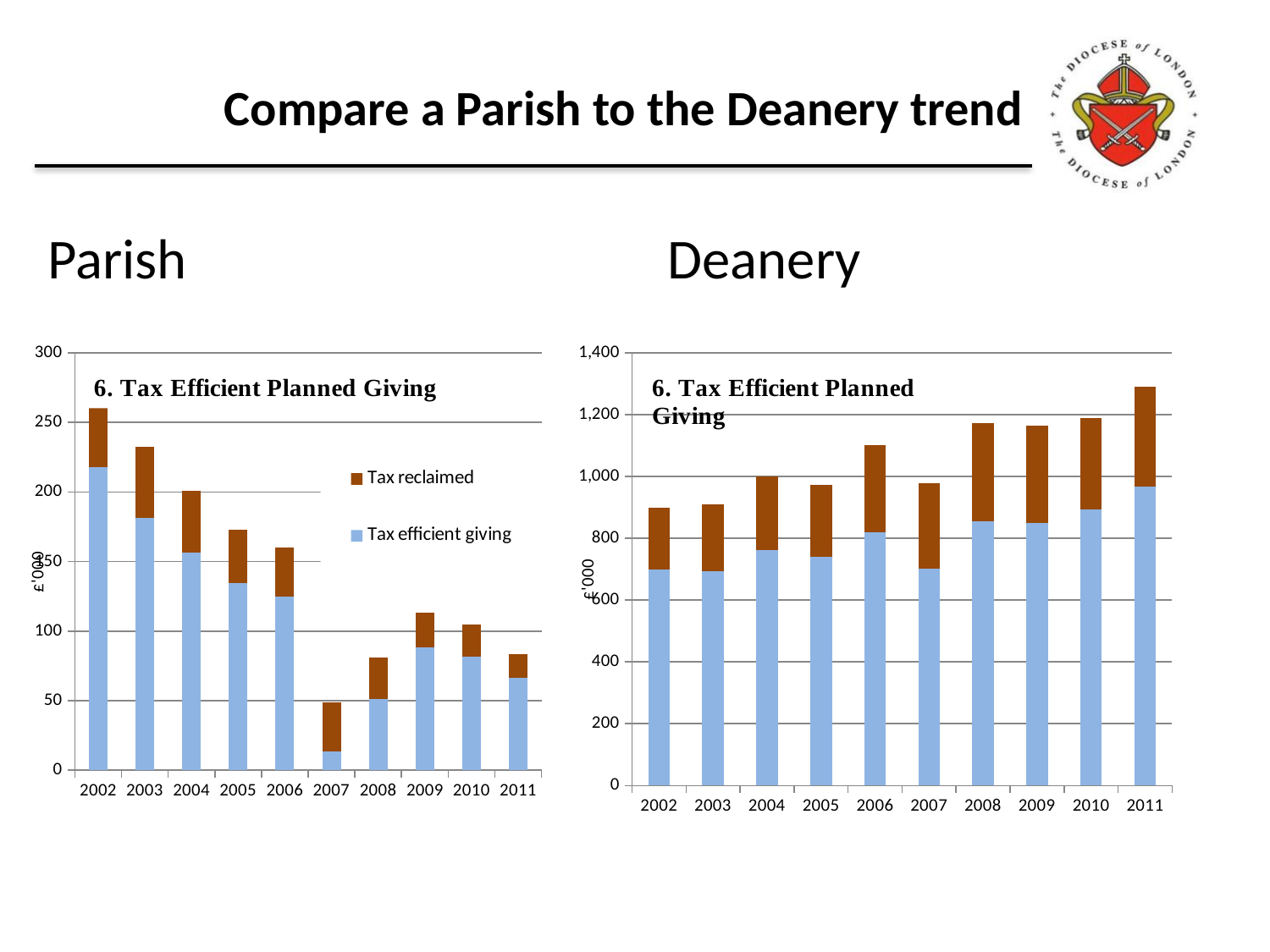
In the Parish chart, which year has the lowest total bar? 2007 How many years are shown on the x axis of the Deanery chart? 10 In the Parish chart, which year has the highest total bar? 2002 What kind of chart is the Parish chart on the left? stacked bar chart In the Parish chart, is the total for 2008 greater or less than 100? less In the Deanery chart, is the total for 2006 greater or less than 1,000? greater In the Parish chart, is the total for 2002 greater or less than 250? greater How many series does the legend of the Parish chart list? 2 In the Deanery chart, which year has the highest total bar? 2011 What is the y-axis unit label on the Parish chart? £'000 In the Deanery chart, is the total for 2011 larger or smaller than the total for 2002? larger